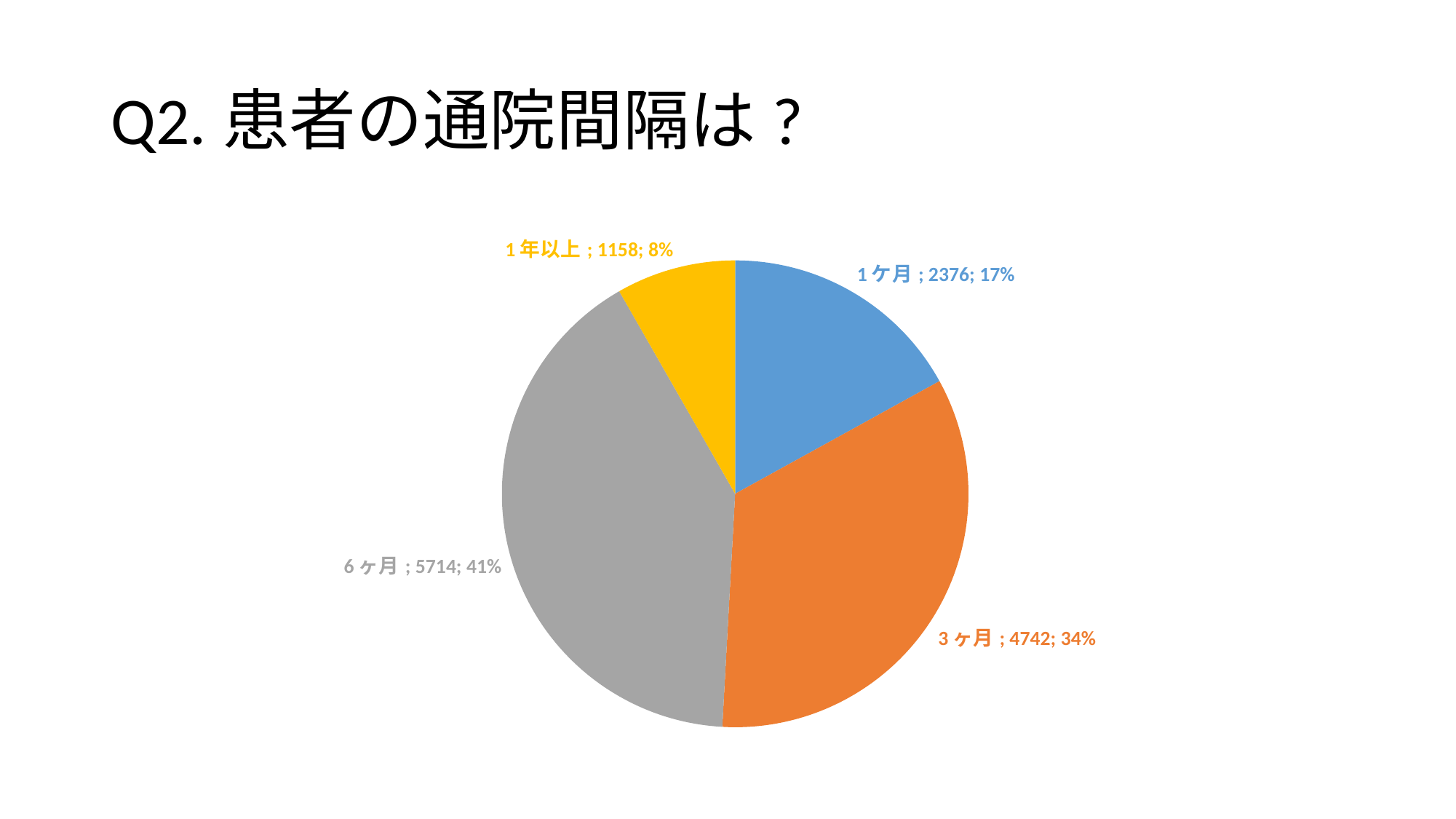
What is the value for 6ヶ月? 5714 What is the value for 1年以上? 1158 Which category has the largest slice? 6ヶ月 What is the value for 1ケ月? 2376 Which is larger, the value for 1ケ月 or the value for 1年以上? 1ケ月 What kind of chart is shown on the slide? pie chart What share of the pie does 3ヶ月 represent? 34% How many slices does the pie chart have? 4 What colour is the slice for 3ヶ月? orange What is the difference between the values for 6ヶ月 and 3ヶ月? 972 What share of the pie does 1年以上 represent? 8% Which category has the smallest slice? 1年以上